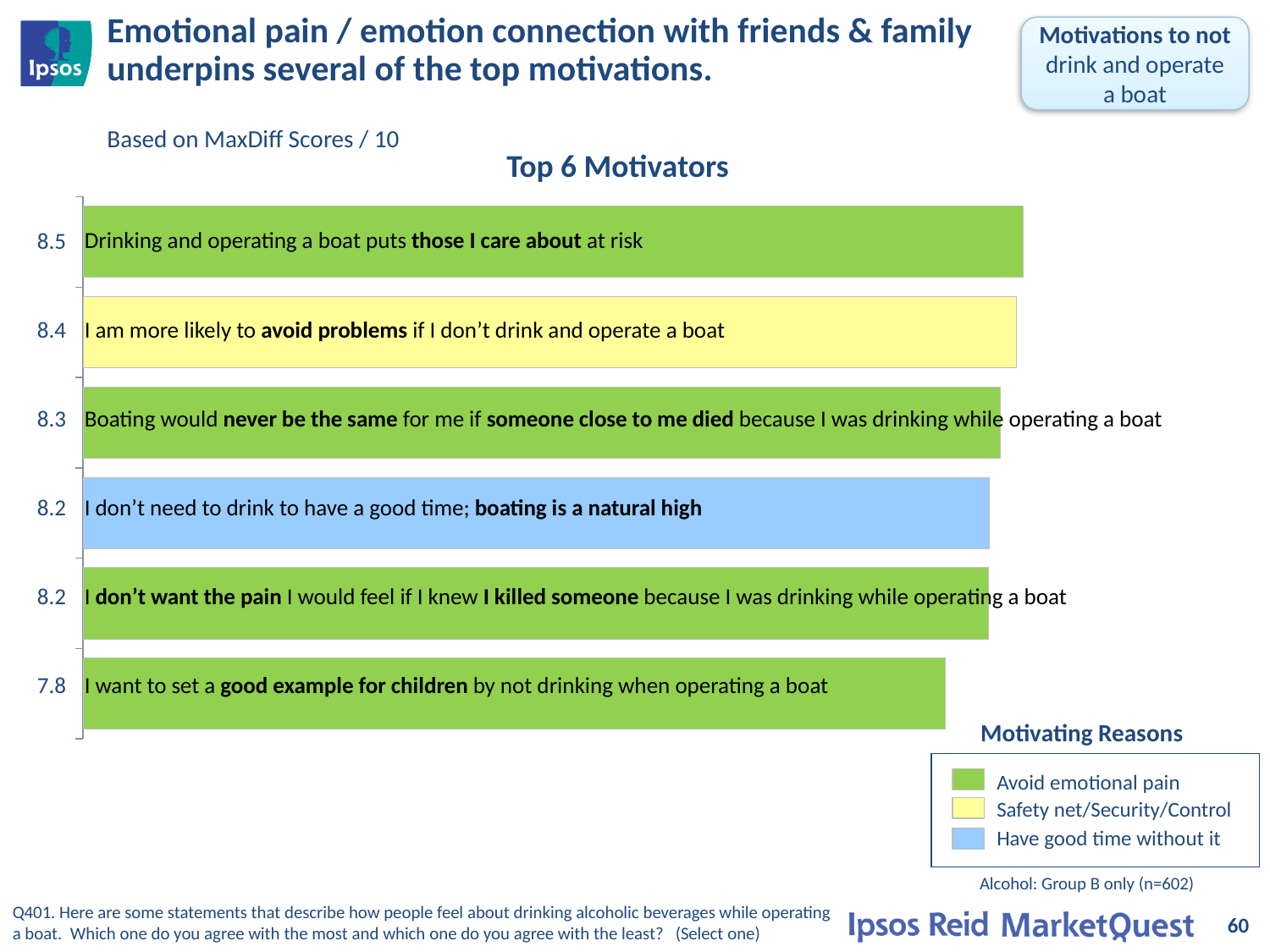
Which motivating reason category does the yellow bar represent? Safety net/Security/Control Which motivator has the lowest MaxDiff score? I want to set a good example for children by not drinking when operating a boat What is the MaxDiff score for "I am more likely to avoid problems if I don't drink and operate a boat"? 8.4 Which has a higher score: "Boating would never be the same for me if someone close to me died..." or "I want to set a good example for children..."? Boating would never be the same for me if someone close to me died because I was drinking while operating a boat What type of chart is used to show the Top 6 Motivators? Bar chart What is the MaxDiff score for "Drinking and operating a boat puts those I care about at risk"? 8.5 How many motivators are shown in the chart? 6 What is the MaxDiff score for "I don't need to drink to have a good time; boating is a natural high"? 8.2 Which motivator has the highest MaxDiff score? Drinking and operating a boat puts those I care about at risk How many categories does the "Motivating Reasons" legend list? 3 What is the MaxDiff score for "I want to set a good example for children by not drinking when operating a boat"? 7.8 What is the difference between the highest and lowest MaxDiff scores shown? 0.7